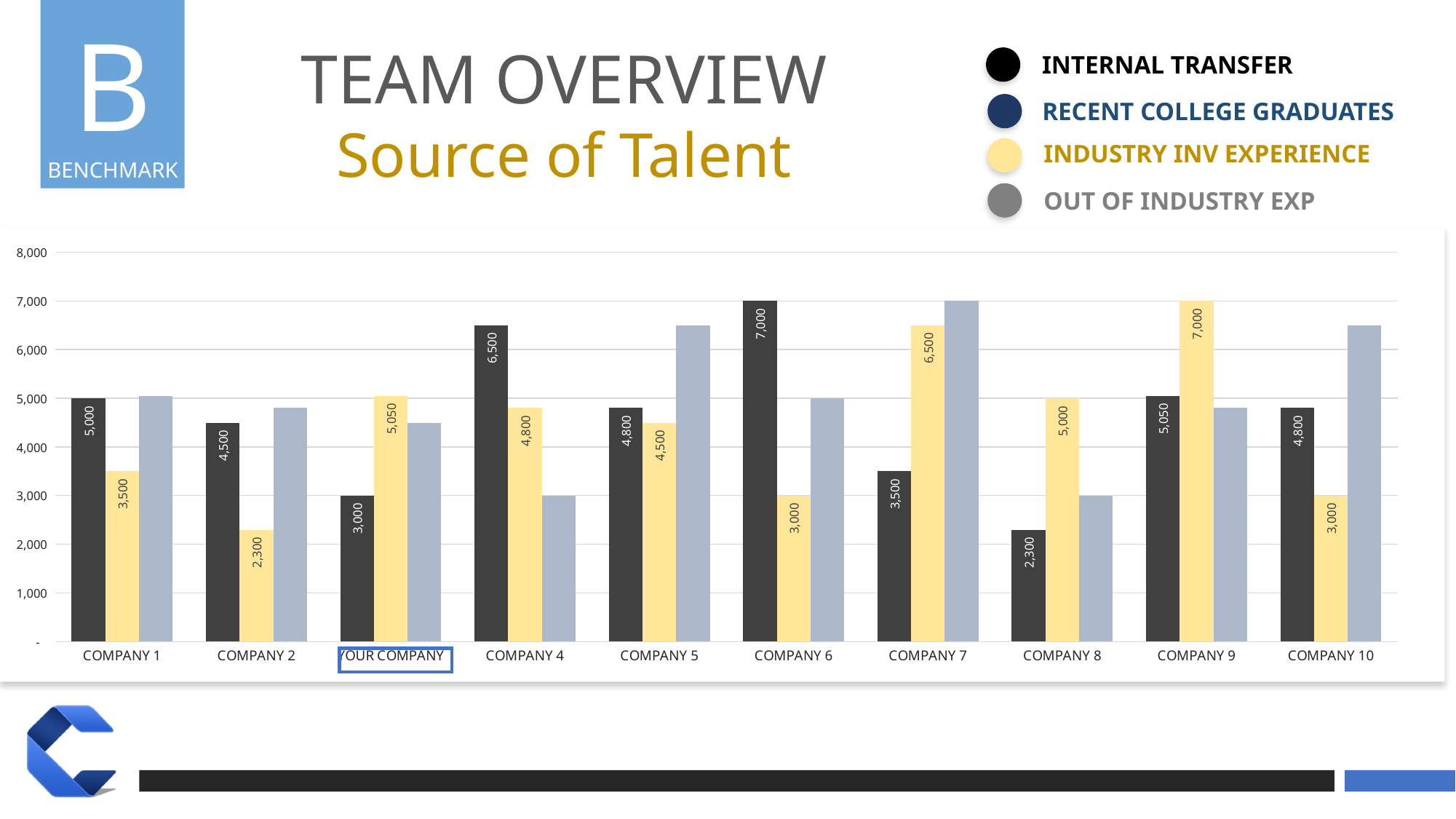
What is the Internal Transfer value for Company 6? 7,000 Which company has the lowest Industry Inv Experience value? Company 2 Is the Out of Industry Exp value for Company 4 greater or less than 4,000? less What is the subtitle of the chart shown below the title 'Team Overview'? Source of Talent How many companies are shown on the x axis of the chart? 10 For Company 9, how much larger is the Industry Inv Experience value than the Internal Transfer value? 1,950 For Company 7, which is larger: Internal Transfer or Industry Inv Experience? Industry Inv Experience Is the Out of Industry Exp value for Company 10 greater or less than 6,000? greater What is the Internal Transfer value for Company 8? 2,300 Which company has the highest Internal Transfer value? Company 6 What is the Industry Inv Experience value for Your Company? 5,050 What kind of chart is shown on the slide? bar chart